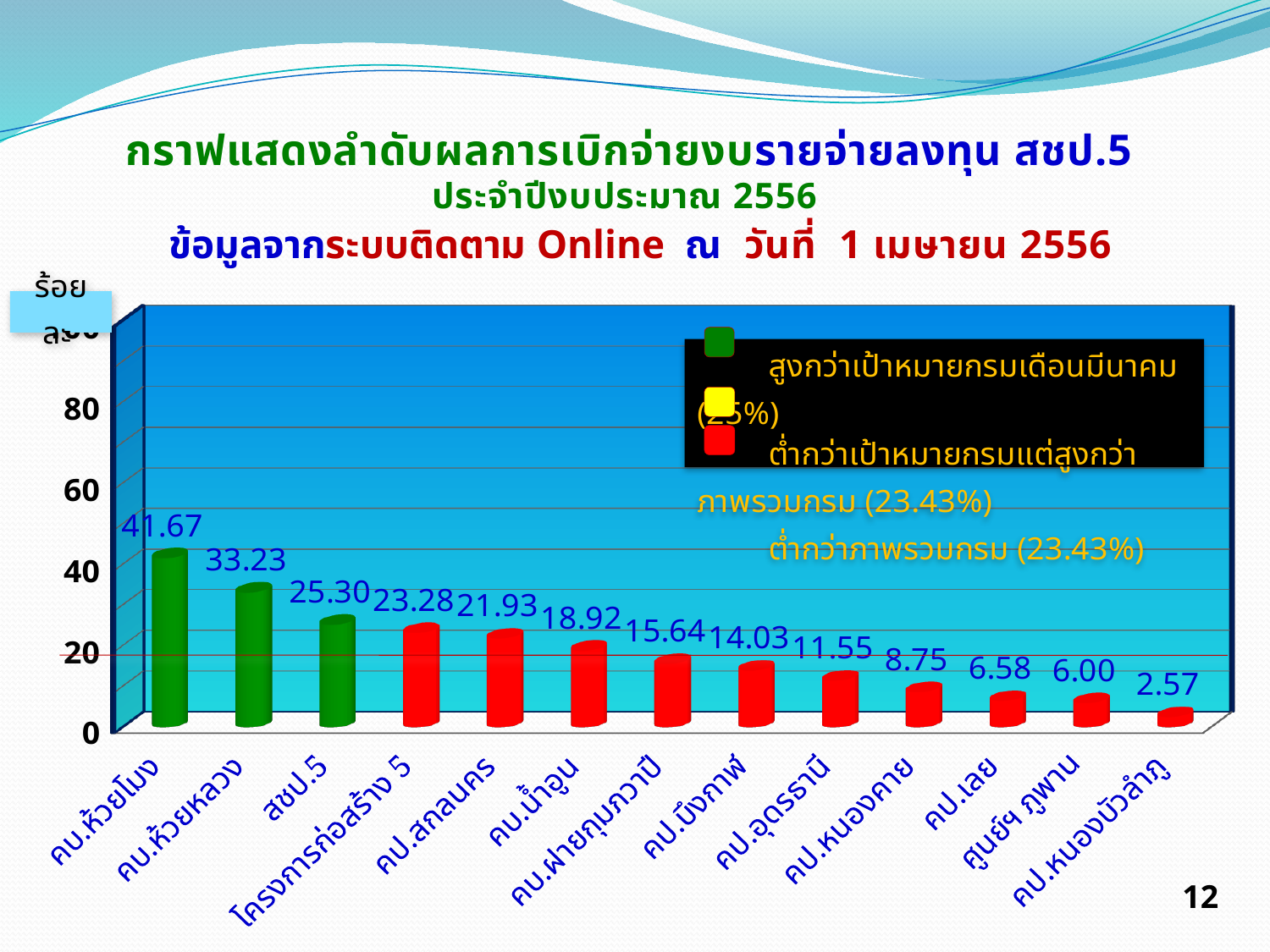
Do the values rise or fall from left to right along the x axis? fall What kind of chart is shown on the slide? bar chart What is the difference between the values for คบ.ห้วยโมง and คบ.ห้วยหลวง? 8.44 How many categories are shown on the x axis? 13 What is the value for คป.สกลนคร? 21.93 Is the value for คป.อุดรธานี greater or less than 20? less Which is larger, the value for สชป.5 or the value for คบ.น้ำอูน? สชป.5 Which category has the lowest value? คป.หนองบัวลำภู What is the value for คบ.ห้วยโมง? 41.67 How many entries does the legend list? 3 Which category has the highest value? คบ.ห้วยโมง What is the value for คป.หนองบัวลำภู? 2.57